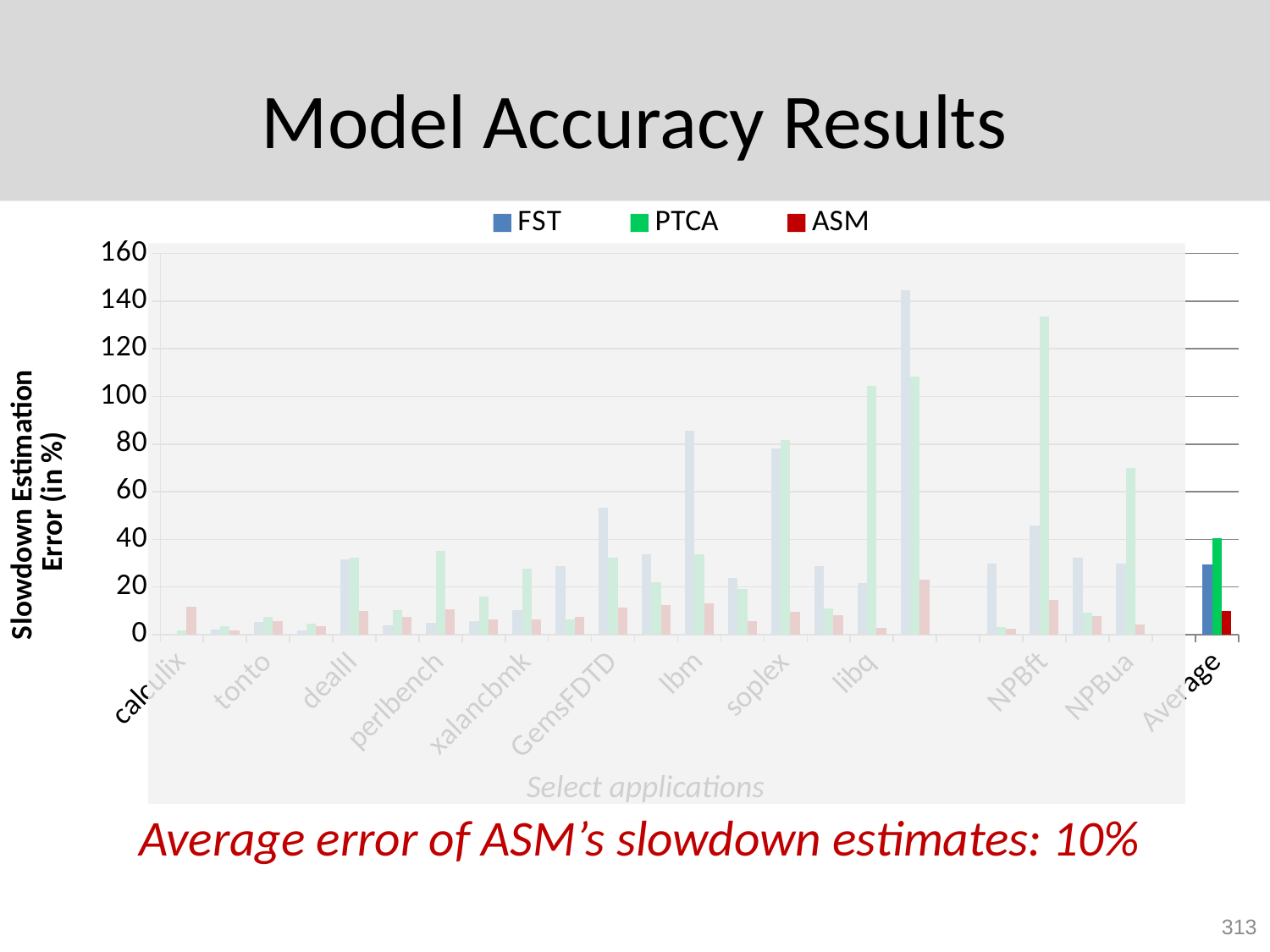
For the Average category, which is larger: the FST value or the ASM value? FST For the Average category, which is larger: the PTCA value or the ASM value? PTCA Which series has the lowest value for the Average category? ASM What kind of chart is shown on the slide? bar chart What is the average error of ASM's slowdown estimates, as stated on the slide? 10% Is the PTCA value for Average greater or less than 60? less Which series is shown in red in the legend? ASM Is the FST value for Average greater or less than 60? less Is the ASM value for Average greater or less than 20? less What is the label of the vertical axis? Slowdown Estimation Error (in %) How many series does the legend list? 3